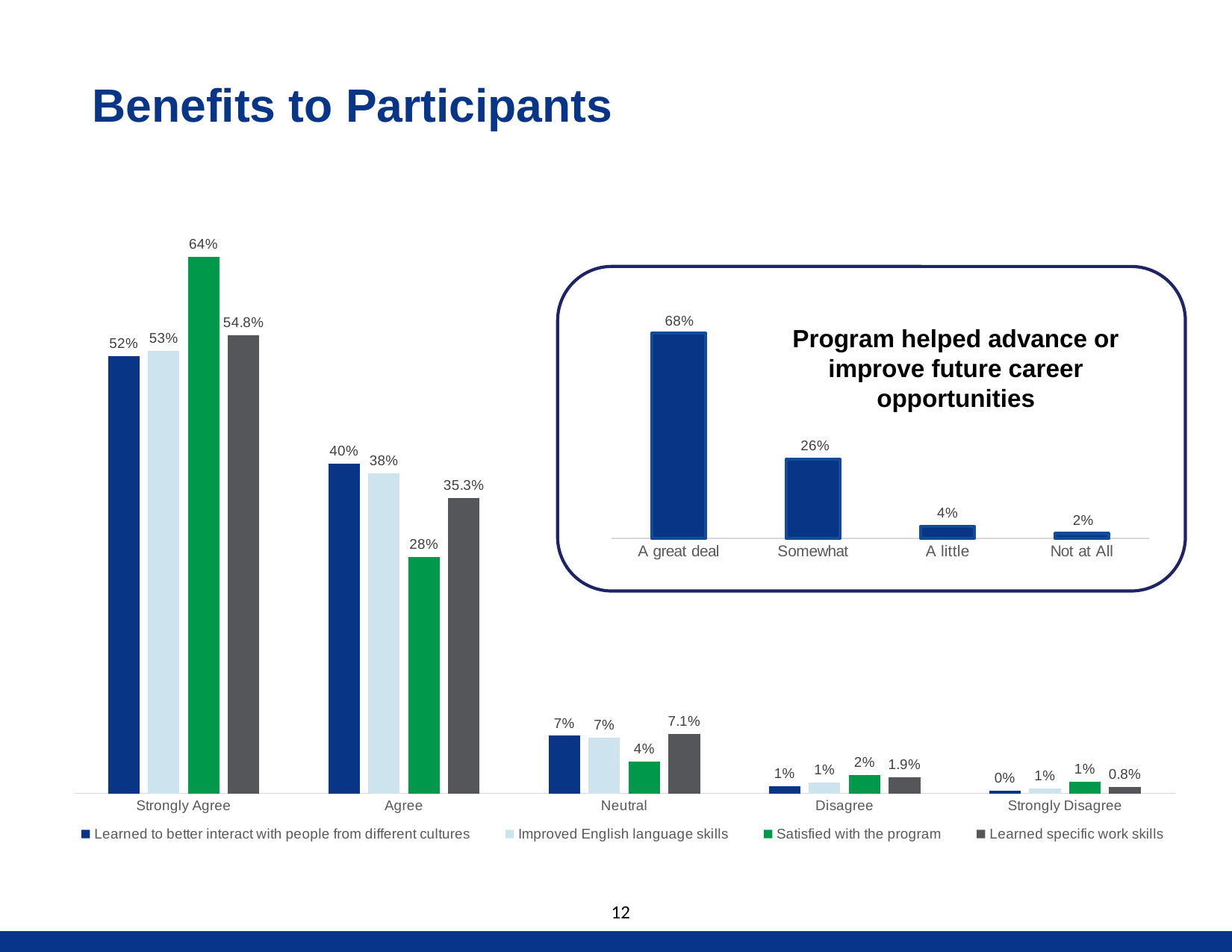
In the chart titled 'Program helped advance or improve future career opportunities', what is the difference between 'A great deal' and 'Somewhat'? 42% How many categories are shown on the x axis of the large bar chart on the left? 5 What kind of chart is the chart titled 'Program helped advance or improve future career opportunities'? Bar chart In the large bar chart on the left, what is the difference between the Strongly Agree and Agree values for 'Satisfied with the program'? 36% In the large bar chart on the left, which series has the lowest value under Agree? Satisfied with the program In the large bar chart on the left, which is larger under Neutral: 'Satisfied with the program' or 'Learned specific work skills'? Learned specific work skills In the chart titled 'Program helped advance or improve future career opportunities', what is the value for Somewhat? 26% In the large bar chart on the left, what is the value for 'Learned specific work skills' under Agree? 35.3% In the large bar chart on the left, what is the value for 'Satisfied with the program' under Strongly Agree? 64% How many series does the legend of the large bar chart on the left list? 4 In the large bar chart on the left, which series has the highest value under Strongly Agree? Satisfied with the program In the chart titled 'Program helped advance or improve future career opportunities', which category has the highest value? A great deal